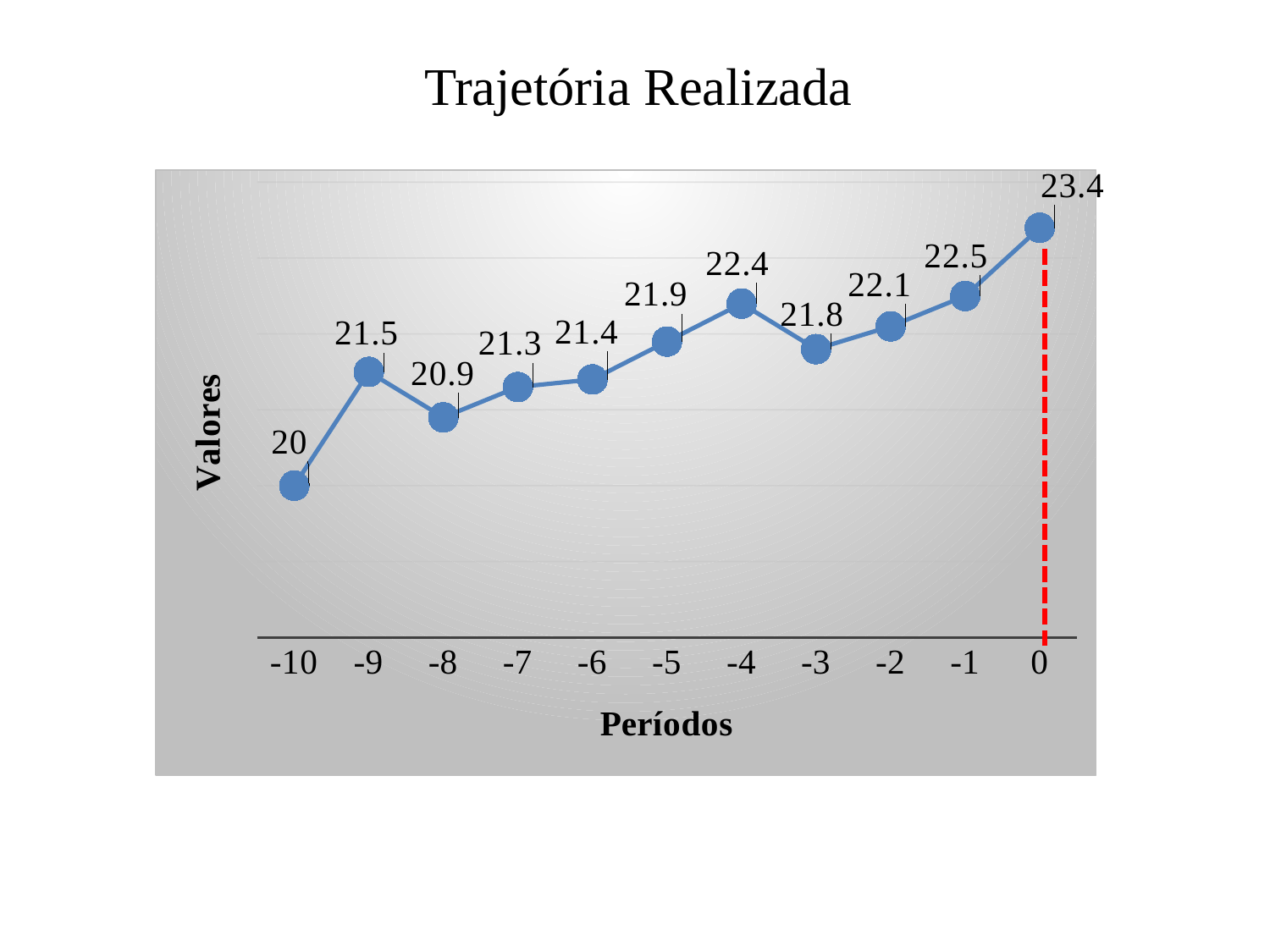
What is the value at period -10? 20 What is the value at period 0? 23.4 Which period has the lowest value? -10 What is the value at period -4? 22.4 How many data points are plotted on the chart? 11 Do the values generally rise or fall from period -10 to period 0? Rise What is the difference between the values at period 0 and period -10? 3.4 Which period has the highest value? 0 Which is larger, the value at period -4 or the value at period -3? -4 What is the title of the chart? Trajetória Realizada What kind of chart is shown on the slide? Line chart What is the value at period -8? 20.9